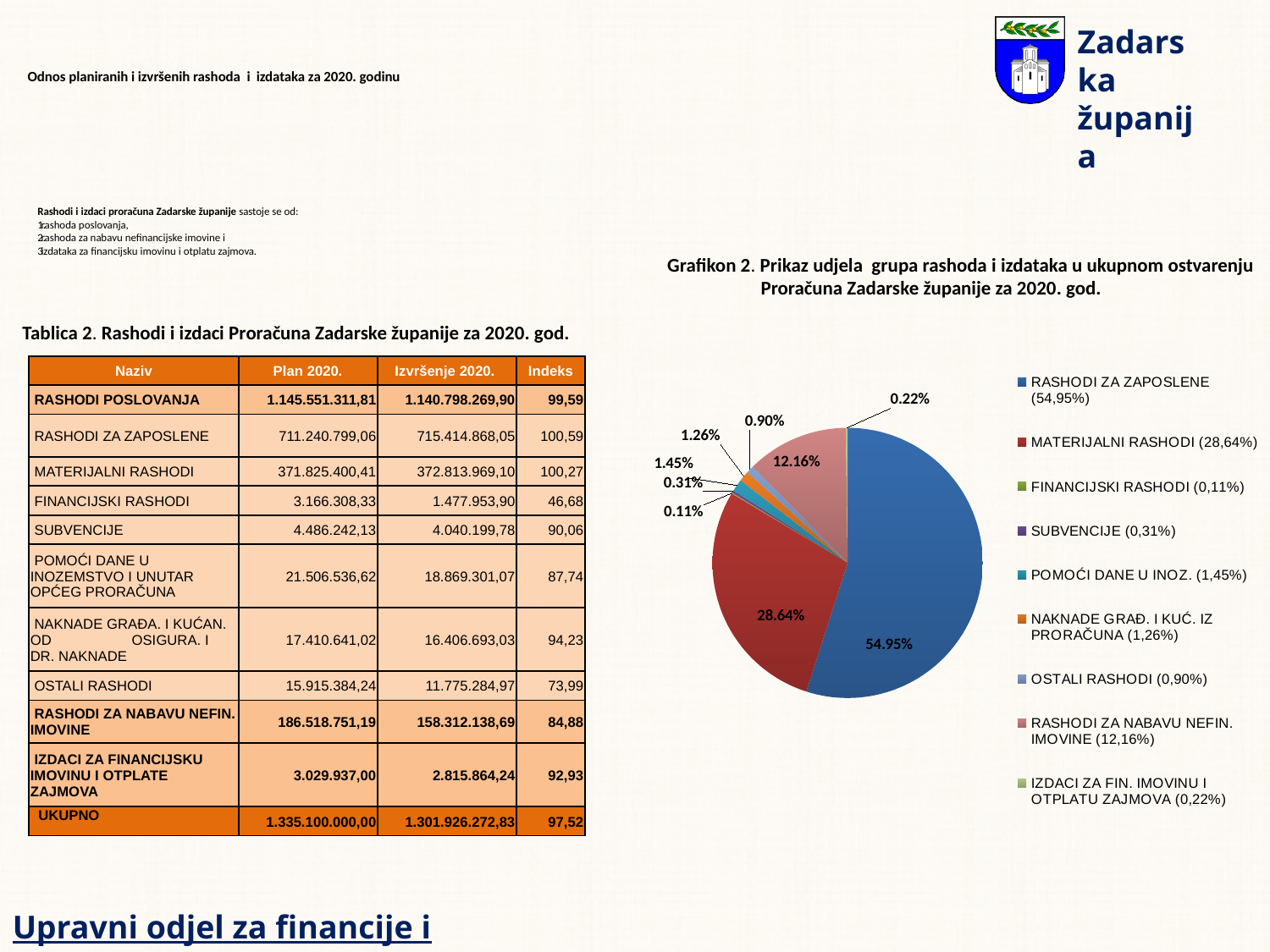
In Grafikon 2, what share does MATERIJALNI RASHODI have? 28.64% How many categories does the legend of Grafikon 2 list? 9 In Grafikon 2, what share does IZDACI ZA FIN. IMOVINU I OTPLATU ZAJMOVA have? 0.22% In Grafikon 2, what is the difference in percentage points between RASHODI ZA ZAPOSLENE and MATERIJALNI RASHODI? 26.31 In Grafikon 2, what colour is the slice for MATERIJALNI RASHODI? red In Grafikon 2, what share does FINANCIJSKI RASHODI have? 0.11% In Grafikon 2, what share does RASHODI ZA NABAVU NEFIN. IMOVINE have? 12.16% In Grafikon 2, which category has the largest slice? RASHODI ZA ZAPOSLENE In Grafikon 2, what share does RASHODI ZA ZAPOSLENE have? 54.95% What kind of chart is Grafikon 2? pie chart In Grafikon 2, which category has the smallest slice? FINANCIJSKI RASHODI In Grafikon 2, which is larger: the share for POMOĆI DANE U INOZ. or the share for OSTALI RASHODI? POMOĆI DANE U INOZ.